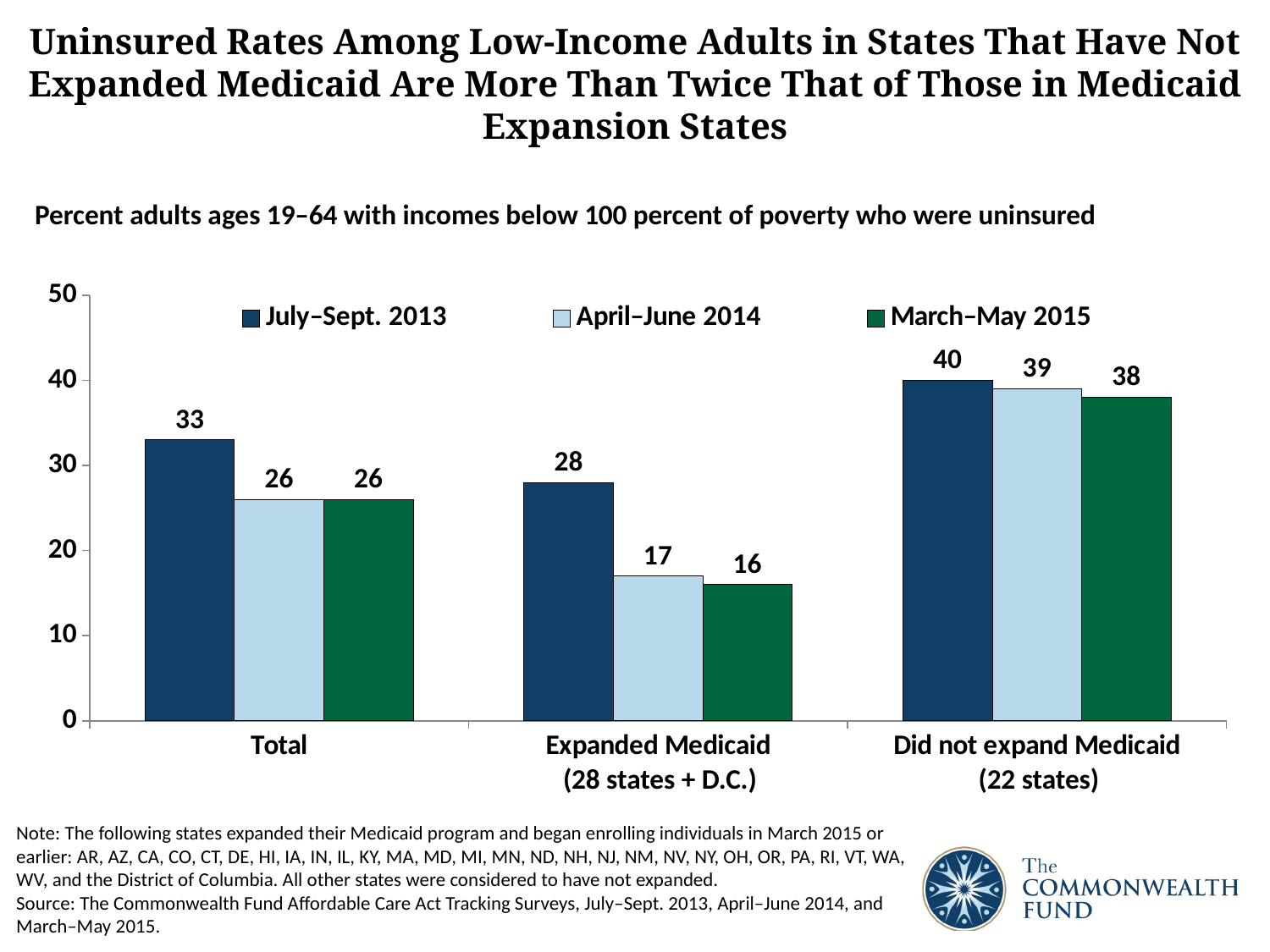
What was the uninsured rate for states that did not expand Medicaid in April–June 2014? 39 Which category had the highest uninsured rate in July–Sept. 2013? Did not expand Medicaid (22 states) By how much did the uninsured rate for Expanded Medicaid states fall from July–Sept. 2013 to April–June 2014? 11 What is the difference between the uninsured rate in states that did not expand Medicaid and in Expanded Medicaid states in March–May 2015? 22 What kind of chart is shown on the slide? Bar chart Which is larger: the Total uninsured rate in July–Sept. 2013 or the Expanded Medicaid rate in July–Sept. 2013? Total What was the uninsured rate for Expanded Medicaid states in March–May 2015? 16 How many series does the legend list? 3 How many categories are shown on the x axis? 3 Did the uninsured rate for Expanded Medicaid states rise or fall from July–Sept. 2013 to March–May 2015? Fall What was the uninsured rate for the Total group in July–Sept. 2013? 33 Which category had the lowest uninsured rate in March–May 2015? Expanded Medicaid (28 states + D.C.)